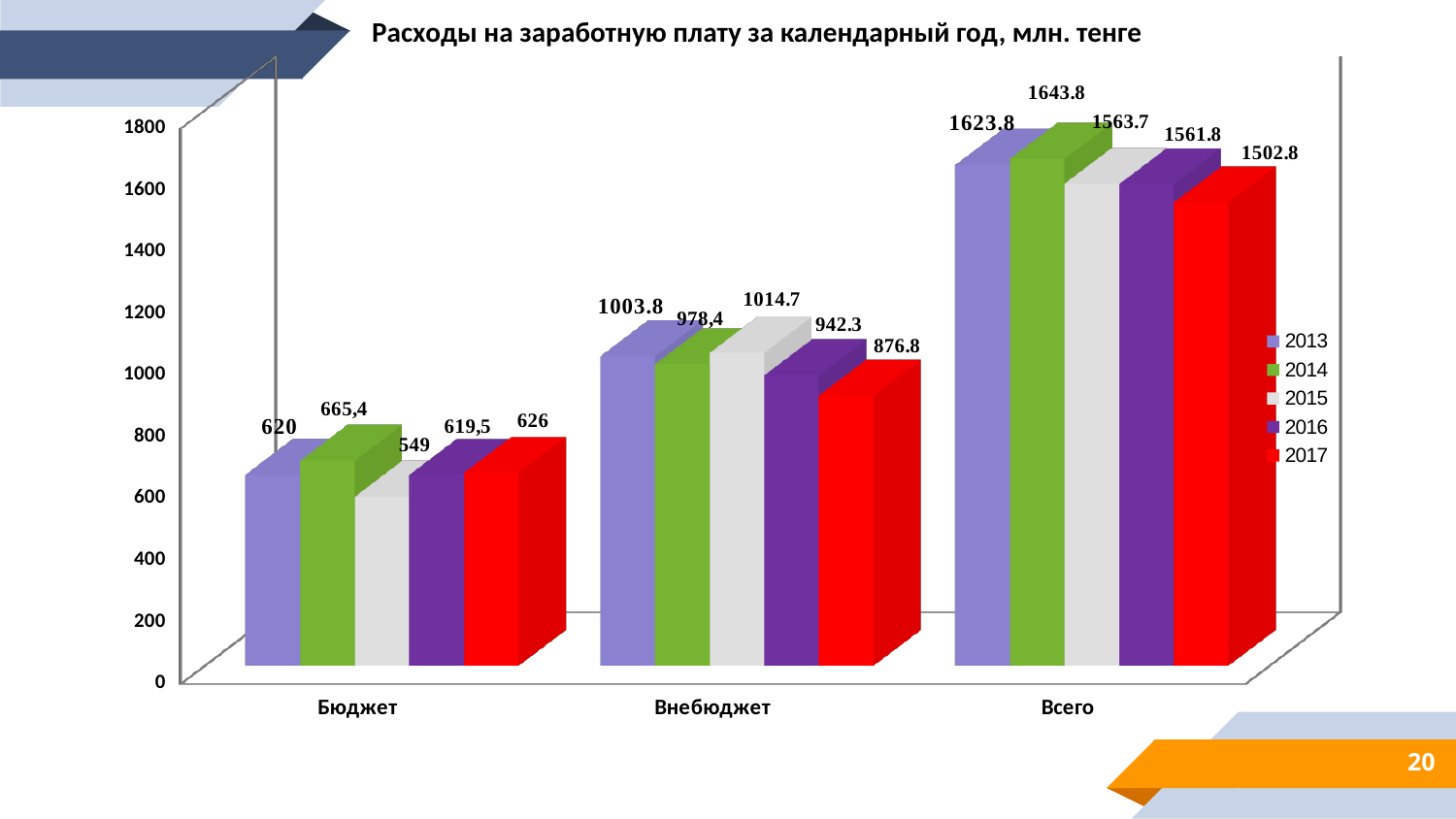
Which year has the highest value in the Внебюджет category? 2015 Which is larger in the Бюджет category: the value for 2014 or the value for 2016? 2014 What is the title of the chart? Расходы на заработную плату за календарный год, млн. тенге How many series does the legend list? 5 What is the value for 2017 in the Внебюджет category? 876.8 Which year has the lowest value in the Всего category? 2017 What is the difference between the 2013 and 2017 values in the Всего category? 121 What is the value for 2014 in the Всего category? 1643.8 Is the value for 2016 in the Внебюджет category greater or less than 1000? less What kind of chart is shown on the slide? bar chart How many categories are shown on the x axis? 3 What is the value for 2015 in the Бюджет category? 549